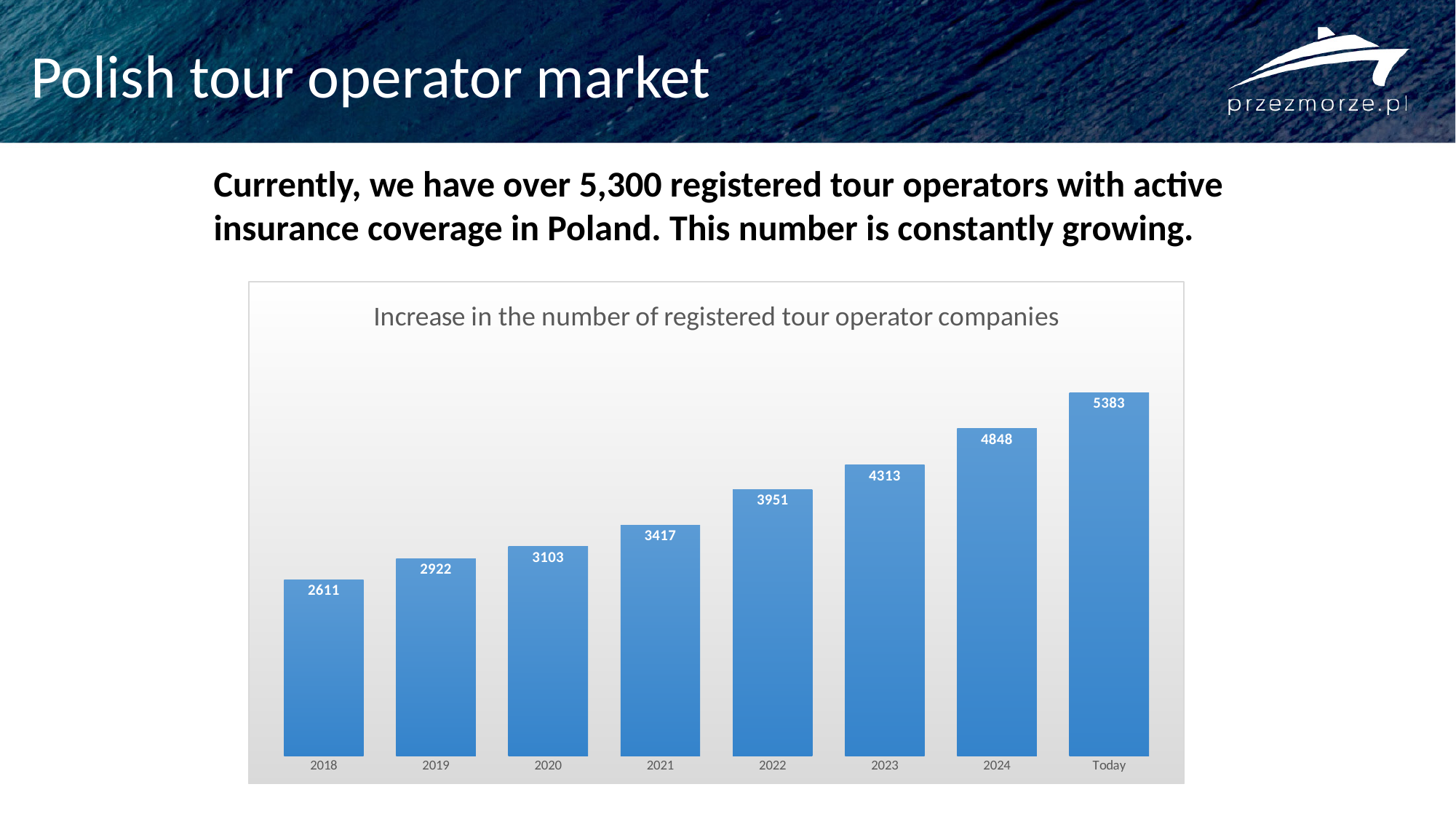
What is the difference between the values for 2024 and 2023? 535 Do the values rise or fall from 2018 to Today? Rise What is the difference between the values for Today and 2018? 2772 What is the value for Today? 5383 What is the value for 2018? 2611 Which category has the highest value? Today How many categories are shown on the x axis? 8 What kind of chart is this? Bar chart Which category has the lowest value? 2018 What is the title of the chart? Increase in the number of registered tour operator companies What is the value for 2022? 3951 Which is larger, the value for 2020 or the value for 2021? 2021